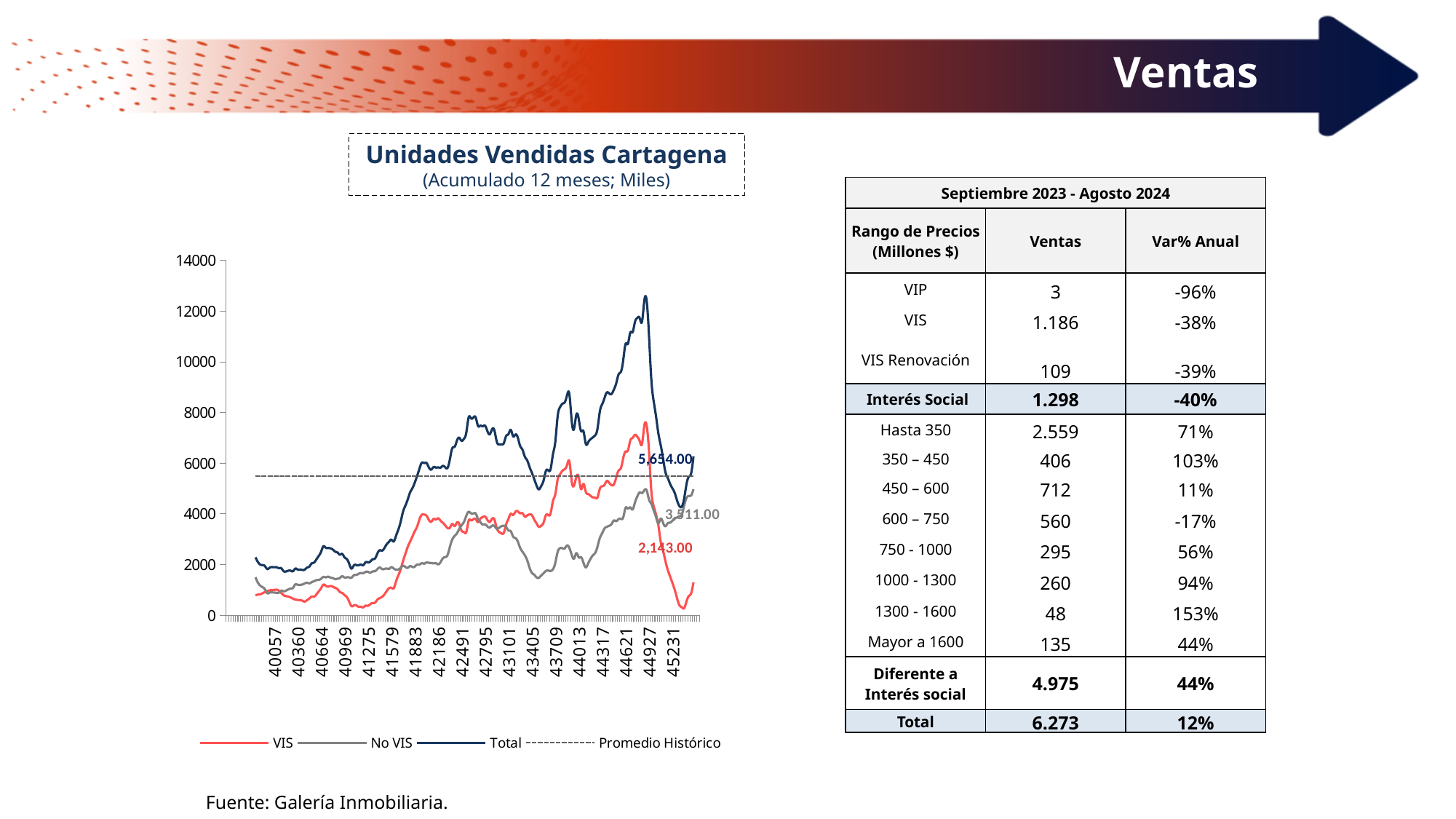
What value is printed as the data label on the VIS series in the 'Unidades Vendidas Cartagena' chart? 2,143.00 Which series reaches the highest value in the 'Unidades Vendidas Cartagena' chart? Total What value is printed as the data label on the No VIS series in the 'Unidades Vendidas Cartagena' chart? 3,511.00 Does the VIS series in the 'Unidades Vendidas Cartagena' chart rise or fall over the last part of the x axis, after its peak near 44927? fall In the 'Unidades Vendidas Cartagena' chart, what is the difference between the labelled Total value (5,654.00) and the labelled No VIS value (3,511.00)? 2,143.00 What value is printed as the data label on the Total series in the 'Unidades Vendidas Cartagena' chart? 5,654.00 Is the peak of the Total series in the 'Unidades Vendidas Cartagena' chart greater or less than 10000? greater In the 'Unidades Vendidas Cartagena' chart, which labelled value is larger: the Total label or the VIS label? Total What kind of chart is shown under the title 'Unidades Vendidas Cartagena'? line chart How many series does the legend of the 'Unidades Vendidas Cartagena' chart list? 4 What colour is the Total series line in the 'Unidades Vendidas Cartagena' chart? dark blue Is the Promedio Histórico line in the 'Unidades Vendidas Cartagena' chart greater or less than 4000? greater